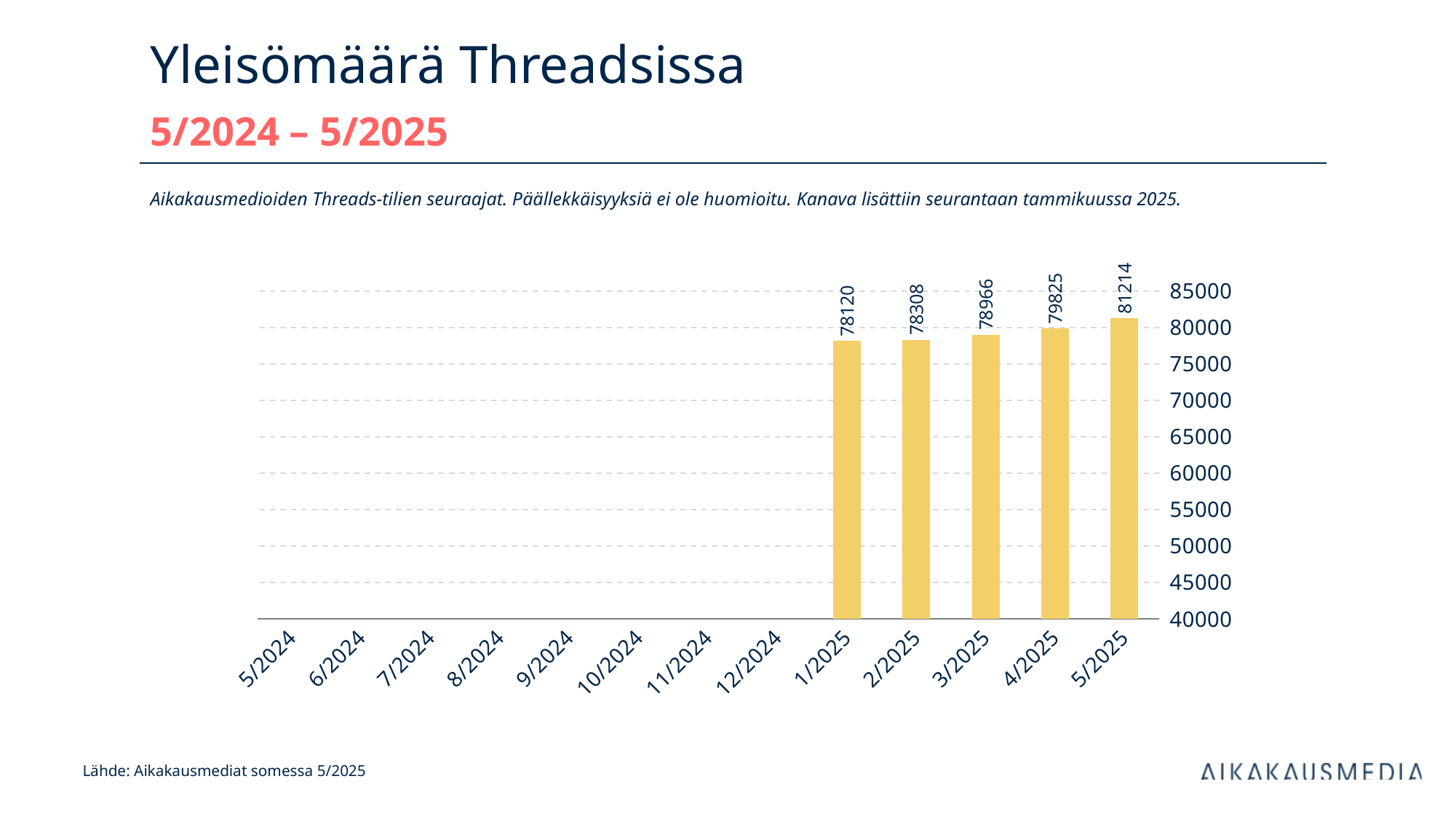
What is the difference between the values for 5/2025 and 1/2025? 3094 Is the value for 5/2025 greater or less than 80000? greater Which month has the highest value? 5/2025 Which is larger, the value for 2/2025 or the value for 4/2025? 4/2025 What is the value for 1/2025? 78120 What kind of chart is shown? bar chart Among the months with bars, which has the lowest value? 1/2025 What is the value for 5/2025? 81214 What is the difference between the values for 4/2025 and 3/2025? 859 How many months are labelled on the x axis? 13 Do the values rise or fall from 1/2025 to 5/2025? rise What is the value for 3/2025? 78966